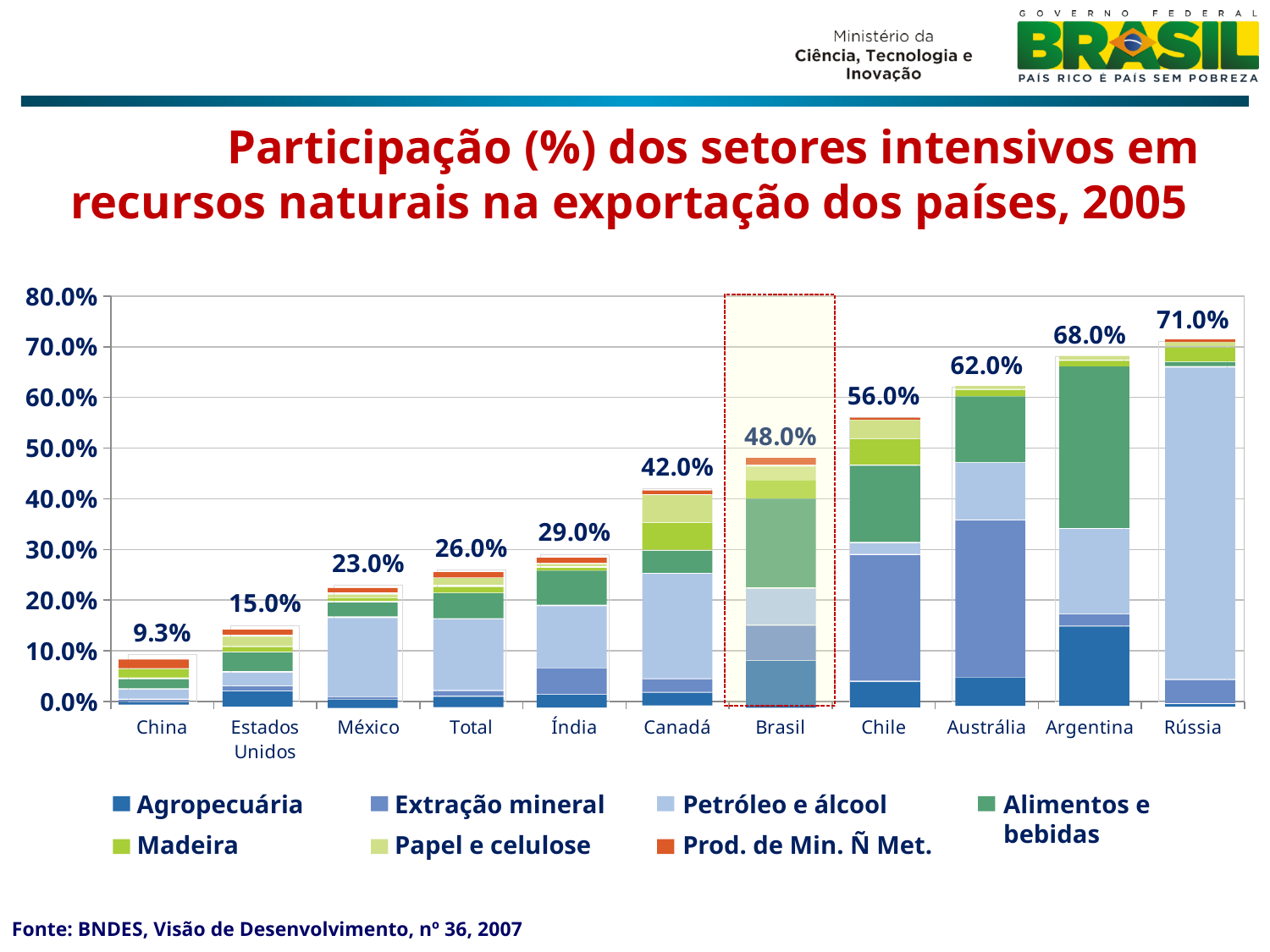
What kind of chart is shown on the slide? Stacked bar chart What is the difference between the total for Argentina and the total for Chile? 12.0% Which has a larger total, Austrália or Índia? Austrália What is the total value shown for China? 9.3% Which country has the highest total share? Rússia Which country has the lowest total share? China What is the total value shown for Canadá? 42.0% What is the total value shown for Brasil? 48.0% How many countries or categories are shown on the x axis? 11 How many series does the legend list? 7 Is the total value for México greater or less than 20.0%? greater Do the total values rise or fall from left to right along the x axis? Rise